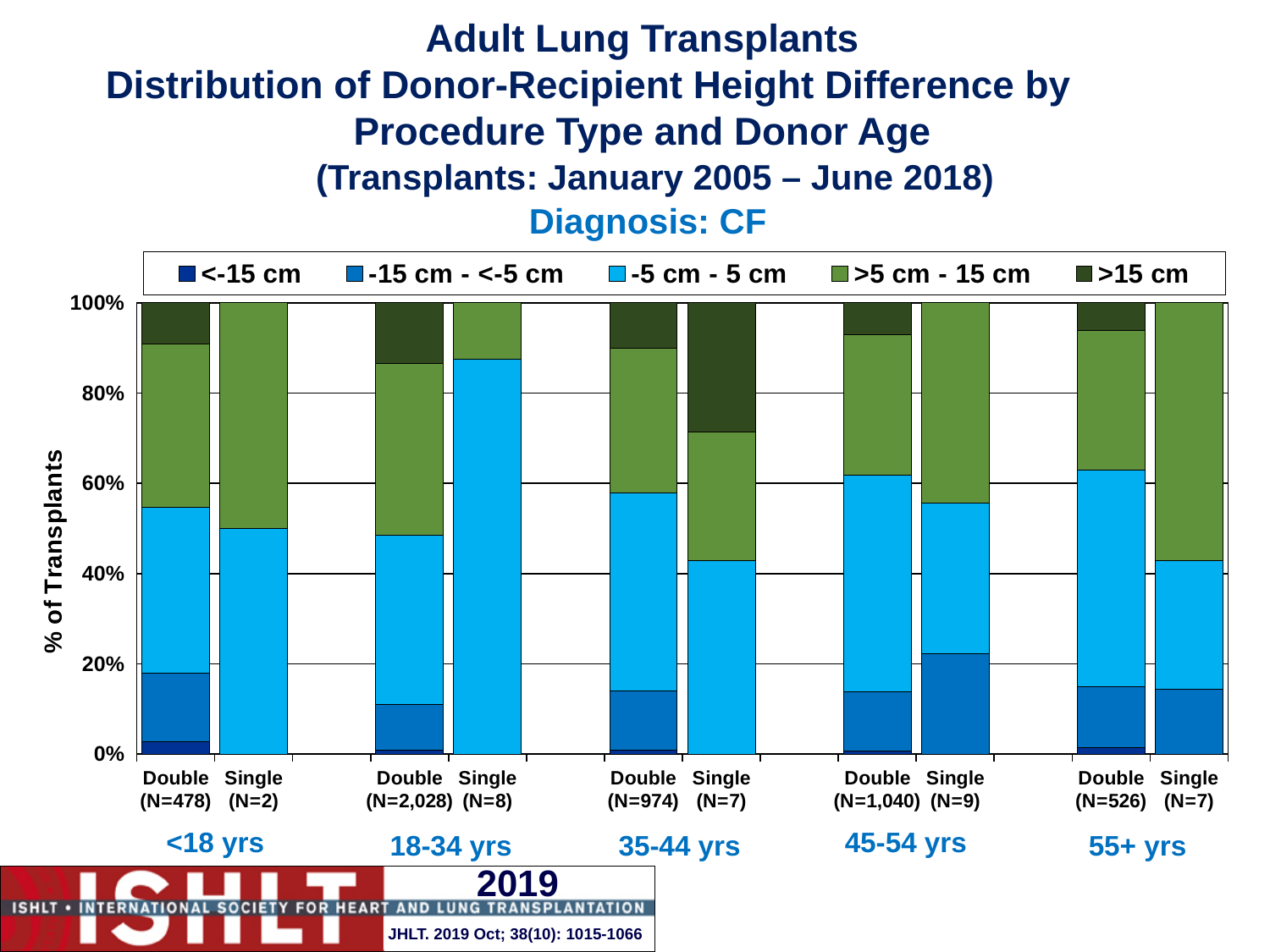
What is the title of the y axis? % of Transplants In the <18 yrs group, is the cumulative top of the -5 cm - 5 cm segment for the Single (N=2) bar greater or less than 60%? less In the 18-34 yrs group, is the cumulative top of the -5 cm - 5 cm segment for the Single (N=8) bar greater or less than 80%? greater How many series does the legend list? 5 Among the Single bars, which age group has the largest >15 cm segment? 35-44 yrs In the 45-54 yrs group, is the top of the -15 cm - <-5 cm segment for the Single (N=9) bar greater or less than 20%? greater How many donor age groups are shown along the x axis? 5 What is the N shown for the Double bar in the 18-34 yrs group? N=2,028 How many bars are plotted in the chart? 10 Among the Single bars, which age group has the largest -5 cm - 5 cm segment? 18-34 yrs What kind of chart is shown on the slide? Stacked bar chart